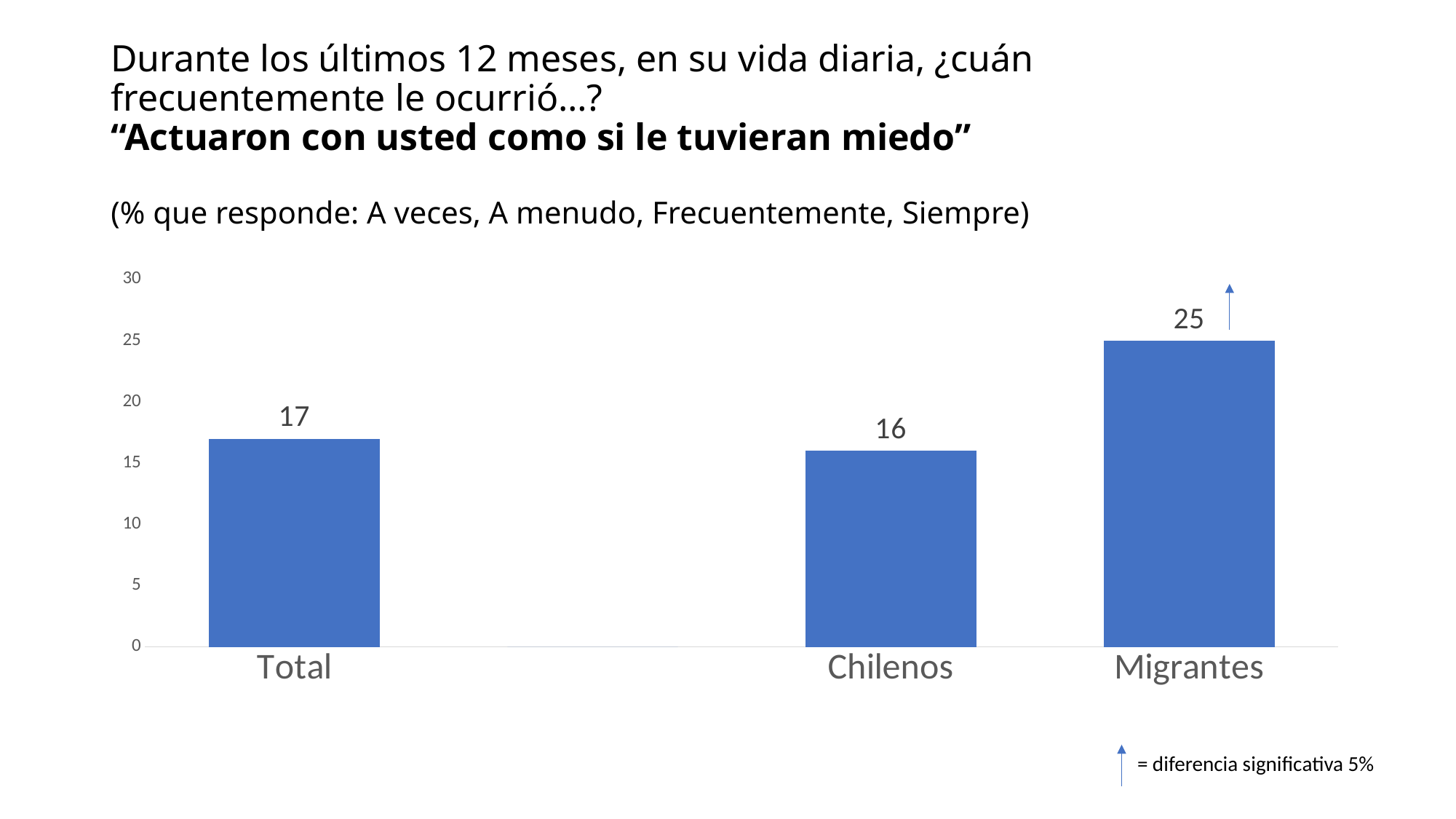
Which category has the lowest value? Chilenos What is the value for Migrantes? 25 Which is larger, the value for Migrantes or the value for Total? Migrantes What does the arrow symbol next to the Migrantes bar indicate, according to the legend note? diferencia significativa 5% How many categories are shown on the x axis? 3 What is the value for Chilenos? 16 What is the difference between the values for Total and Chilenos? 1 What is the difference between the values for Migrantes and Chilenos? 9 Is the value for Migrantes greater or less than 20? greater What is the value for Total? 17 Which category has the highest value? Migrantes What kind of chart is shown on the slide? bar chart